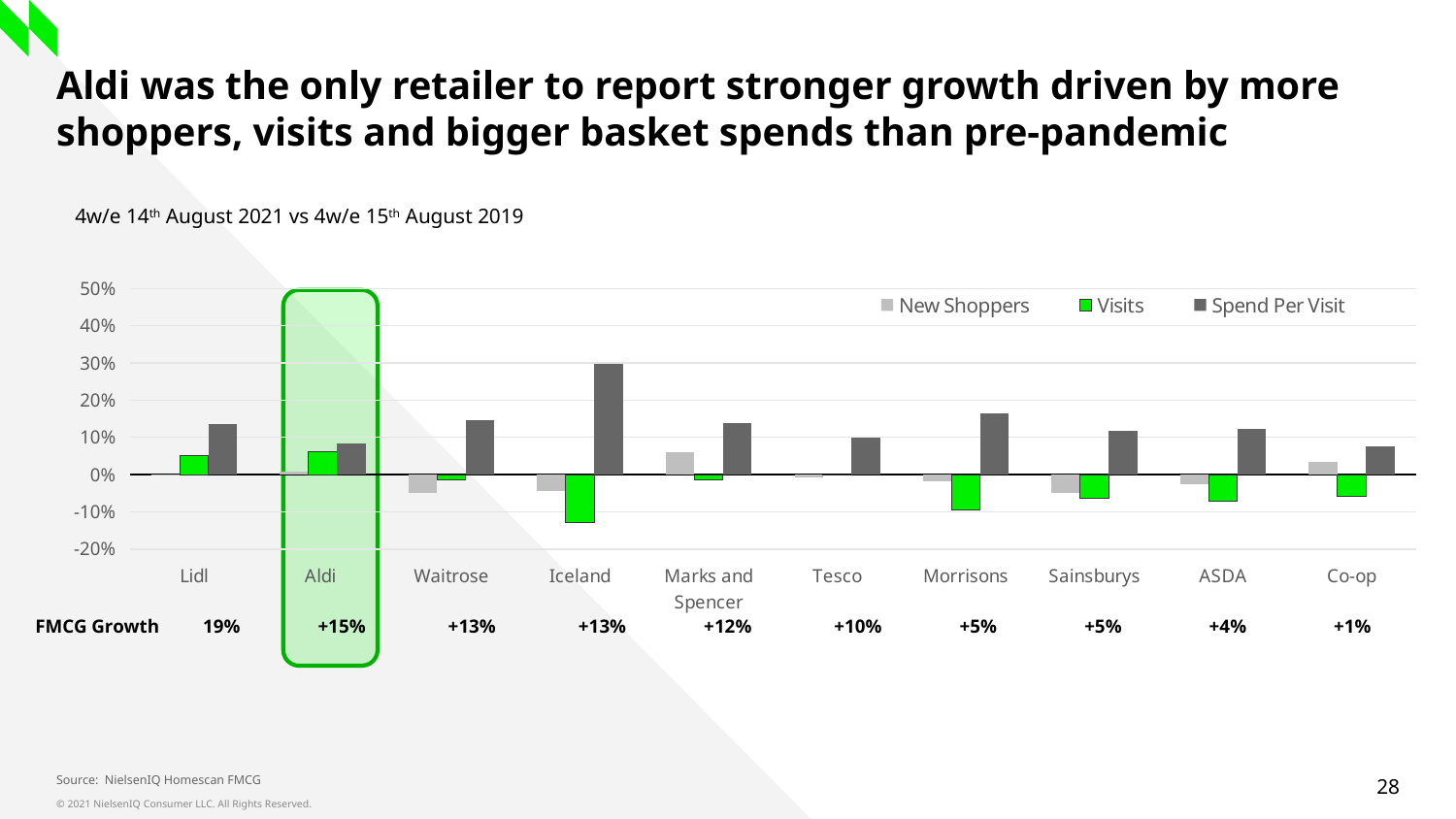
Which retailer has the highest Spend Per Visit value? Iceland How many retailers are shown on the x axis? 10 Which retailer has the lowest Visits value? Iceland How many series does the legend list? 3 Which retailer is highlighted with a green box on the chart? Aldi What is the FMCG Growth figure shown for Aldi? +15% Is the Visits value for Iceland greater or less than -10%? less What is the FMCG Growth figure shown for Lidl? 19% What kind of chart is shown on the slide? bar chart Is the Spend Per Visit value for Morrisons greater or less than 10%? greater Is the Spend Per Visit value for Iceland greater or less than 20%? greater Which is larger, the Visits value for Aldi or the Visits value for Waitrose? Aldi